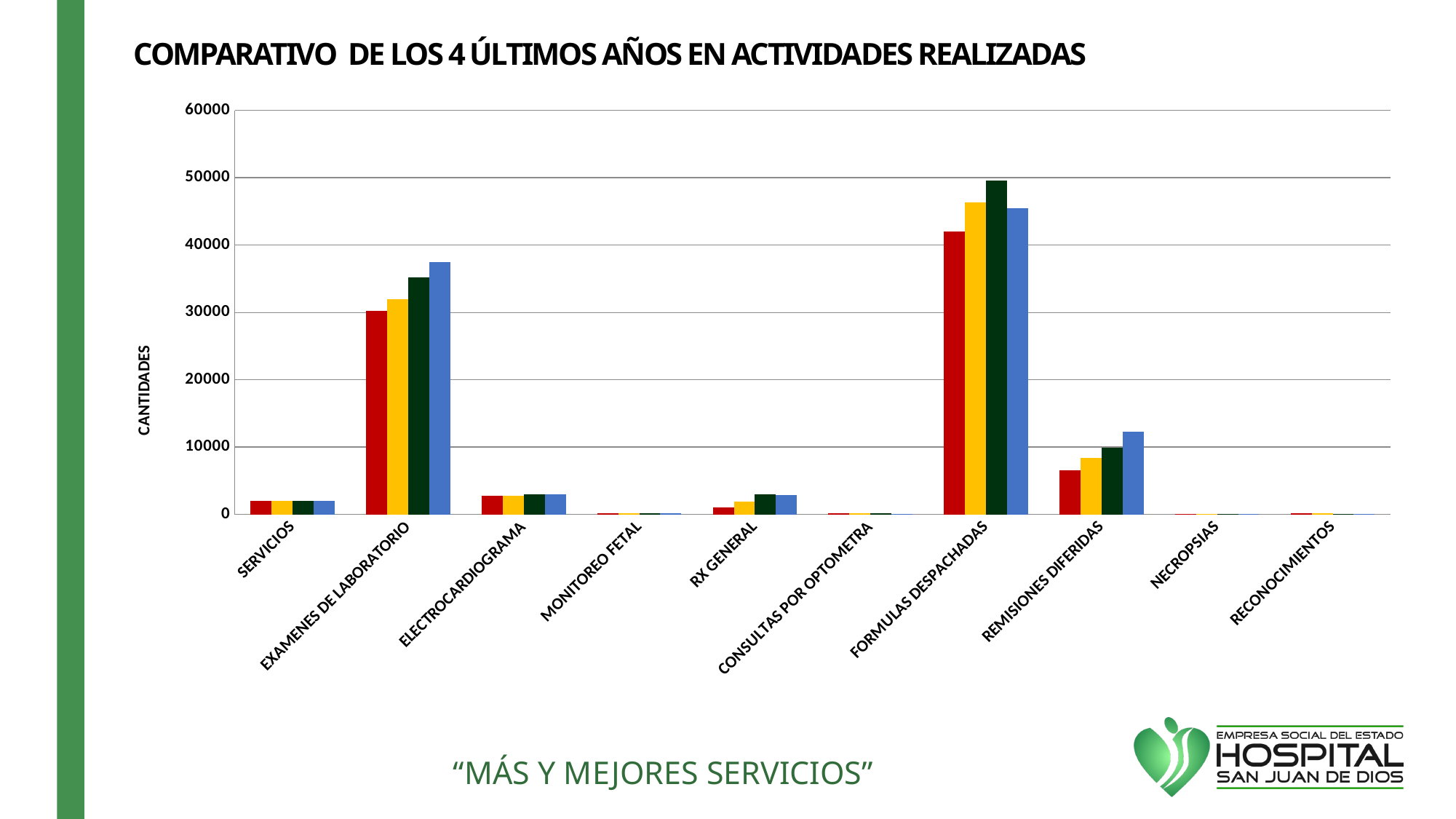
Is the tallest bar for FORMULAS DESPACHADAS greater or less than 40000? greater Is the red bar for EXAMENES DE LABORATORIO greater or less than 40000? less Which category has the tallest bars in the chart? FORMULAS DESPACHADAS What kind of chart is shown on the slide? bar chart Which category has larger values, REMISIONES DIFERIDAS or ELECTROCARDIOGRAMA? REMISIONES DIFERIDAS Is the tallest bar for EXAMENES DE LABORATORIO greater or less than 30000? greater How many bars are plotted for each category in the chart? 4 Do the four bars for EXAMENES DE LABORATORIO rise or fall from left to right? rise What is the label on the vertical axis of the chart? CANTIDADES Which category has larger values, FORMULAS DESPACHADAS or EXAMENES DE LABORATORIO? FORMULAS DESPACHADAS How many categories are shown on the x axis of the chart? 10